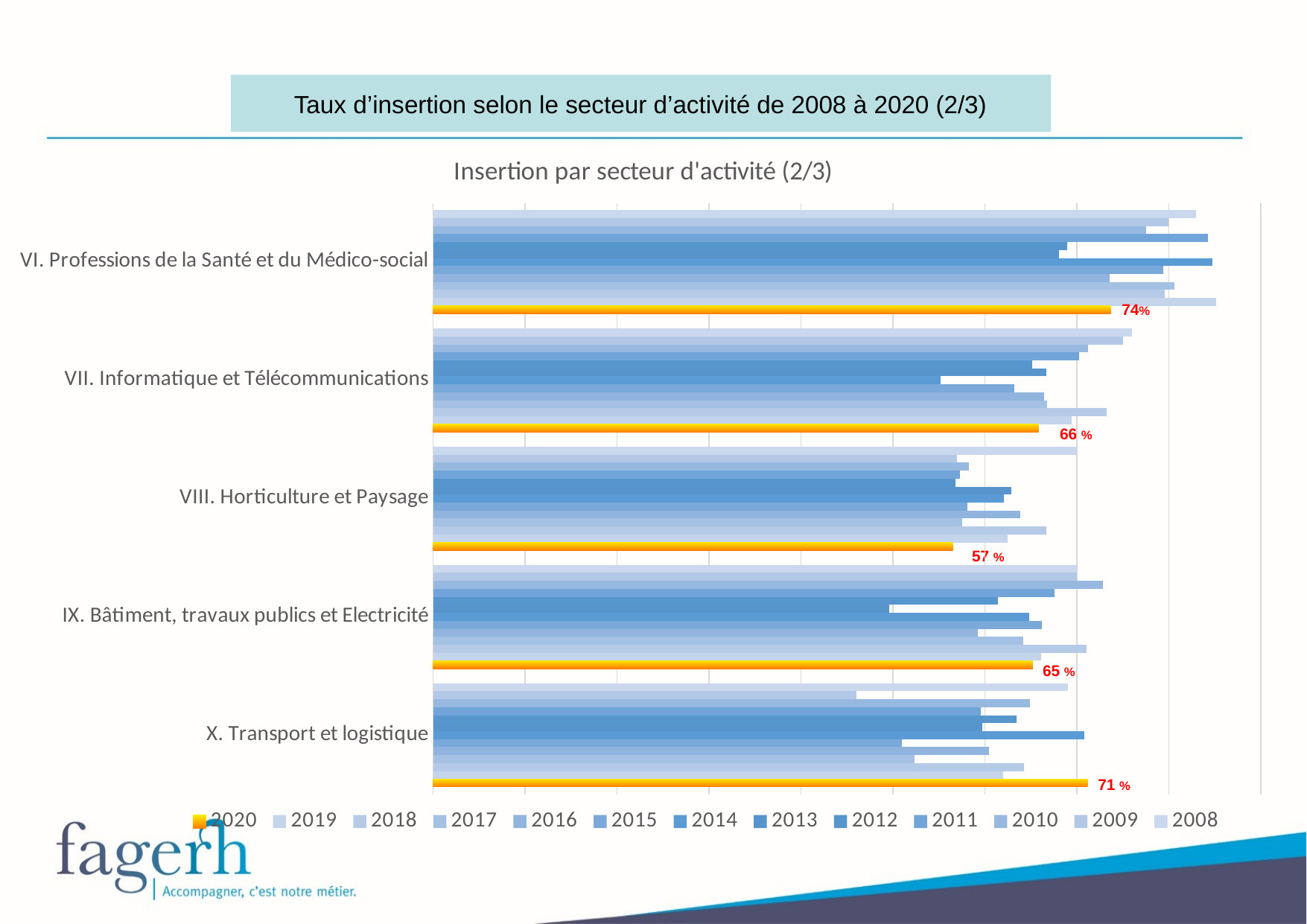
How many series (years) does the legend list? 13 What is the 2020 insertion rate for VI. Professions de la Santé et du Médico-social? 74% What kind of chart is shown on the slide? Bar chart Which has the larger 2020 value: X. Transport et logistique or IX. Bâtiment, travaux publics et Electricité? X. Transport et logistique Which sector has the highest 2020 insertion rate? VI. Professions de la Santé et du Médico-social What is the 2020 value for X. Transport et logistique? 71% What is the 2020 value for VIII. Horticulture et Paysage? 57% How many sectors are shown on the chart? 5 What is the difference between the 2020 values for VI. Professions de la Santé et du Médico-social and VIII. Horticulture et Paysage? 17 percentage points What is the 2020 value for VII. Informatique et Télécommunications? 66% Which sector has the lowest 2020 insertion rate? VIII. Horticulture et Paysage What is the title of the chart? Insertion par secteur d'activité (2/3)